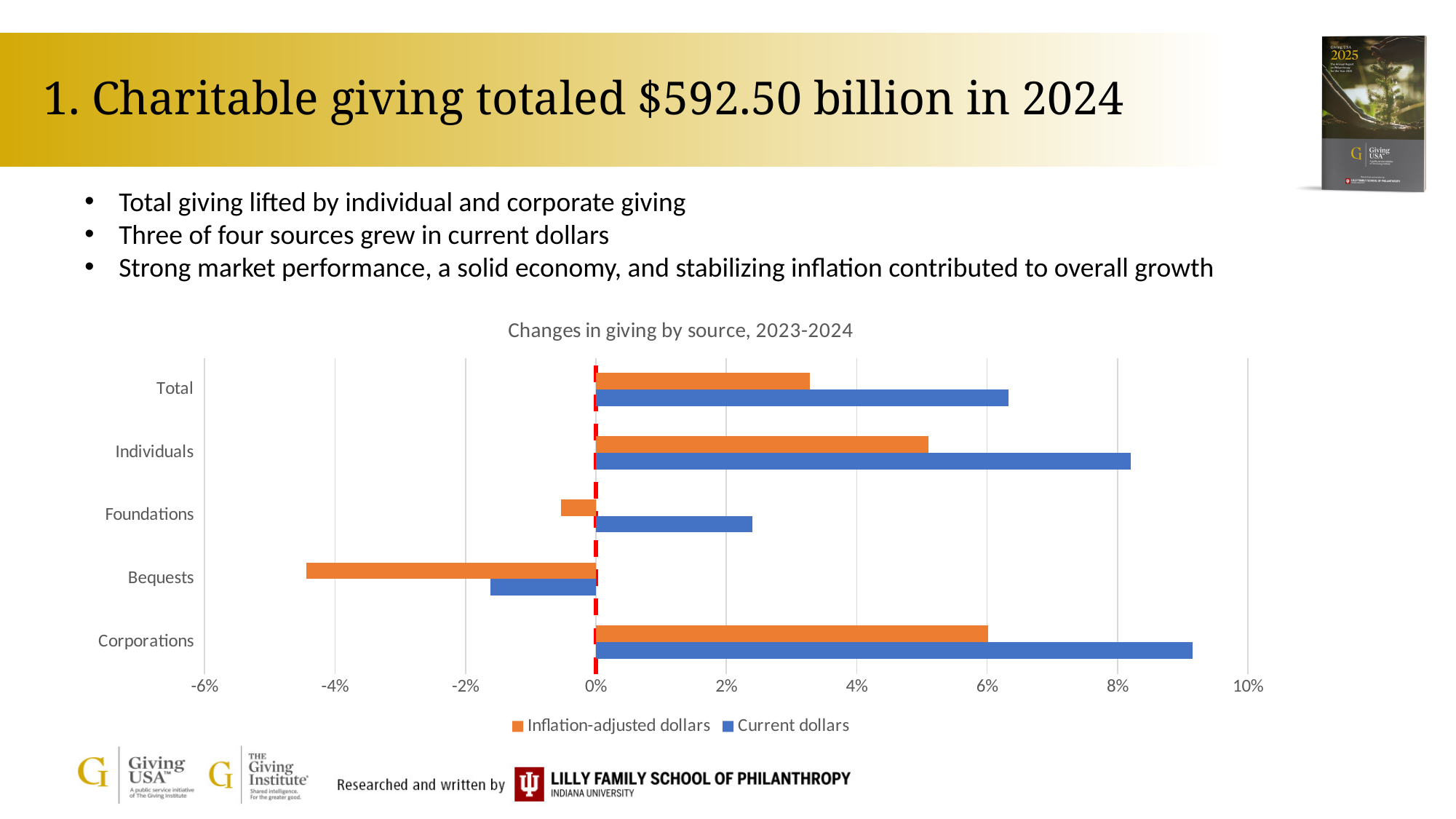
Which is larger for Current dollars: Individuals or Total? Individuals Is the Current dollars value for Corporations greater or less than 8%? greater Which colour represents Inflation-adjusted dollars in the chart? Orange Which category has the lowest value for Inflation-adjusted dollars? Bequests Which category has the lowest value for Current dollars? Bequests Is the Current dollars value for Foundations greater or less than 4%? less How many series does the chart legend list? 2 Which category has the highest value for Current dollars? Corporations What type of chart is shown on the slide? Bar chart How many source categories are shown on the chart? 5 Is the Inflation-adjusted dollars value for Bequests greater or less than -4%? less What is the title of the chart? Changes in giving by source, 2023-2024